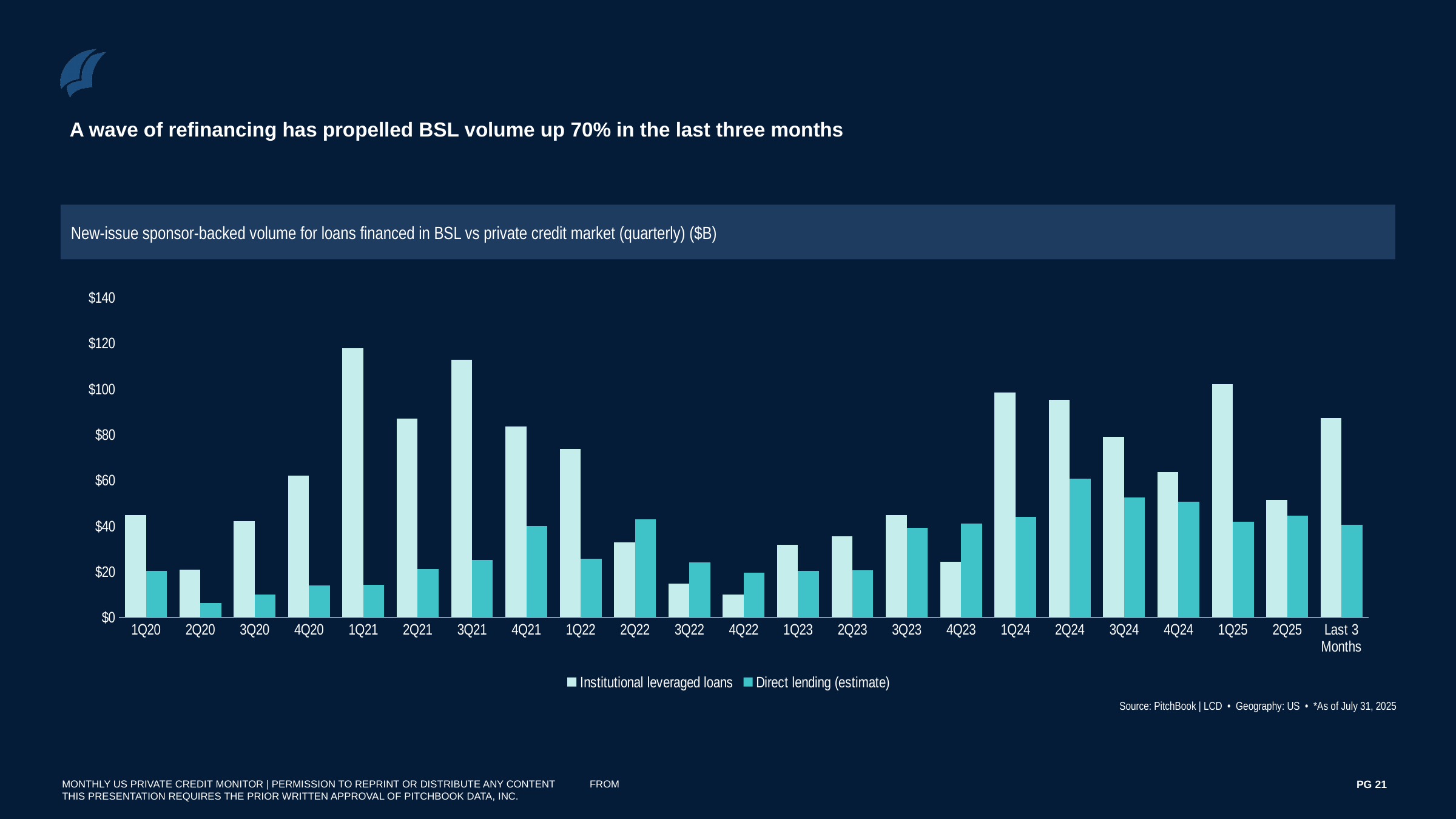
In which period is the Institutional leveraged loans value lowest? 4Q22 In which period is the Direct lending (estimate) value highest? 2Q24 Is the Institutional leveraged loans value for 1Q21 greater or less than $100? greater How many periods are shown along the x axis? 23 In 2Q22, which series has the larger value: Institutional leveraged loans or Direct lending (estimate)? Direct lending (estimate) Is the Direct lending (estimate) value for 2Q20 greater or less than $20? less In which period is the Institutional leveraged loans value highest? 1Q21 What is the title of the chart? New-issue sponsor-backed volume for loans financed in BSL vs private credit market (quarterly) ($B) What kind of chart is shown on the slide? bar chart How many series does the legend list? 2 Does the Institutional leveraged loans value rise or fall from 1Q21 to 4Q22? fall In which period is the Direct lending (estimate) value lowest? 2Q20